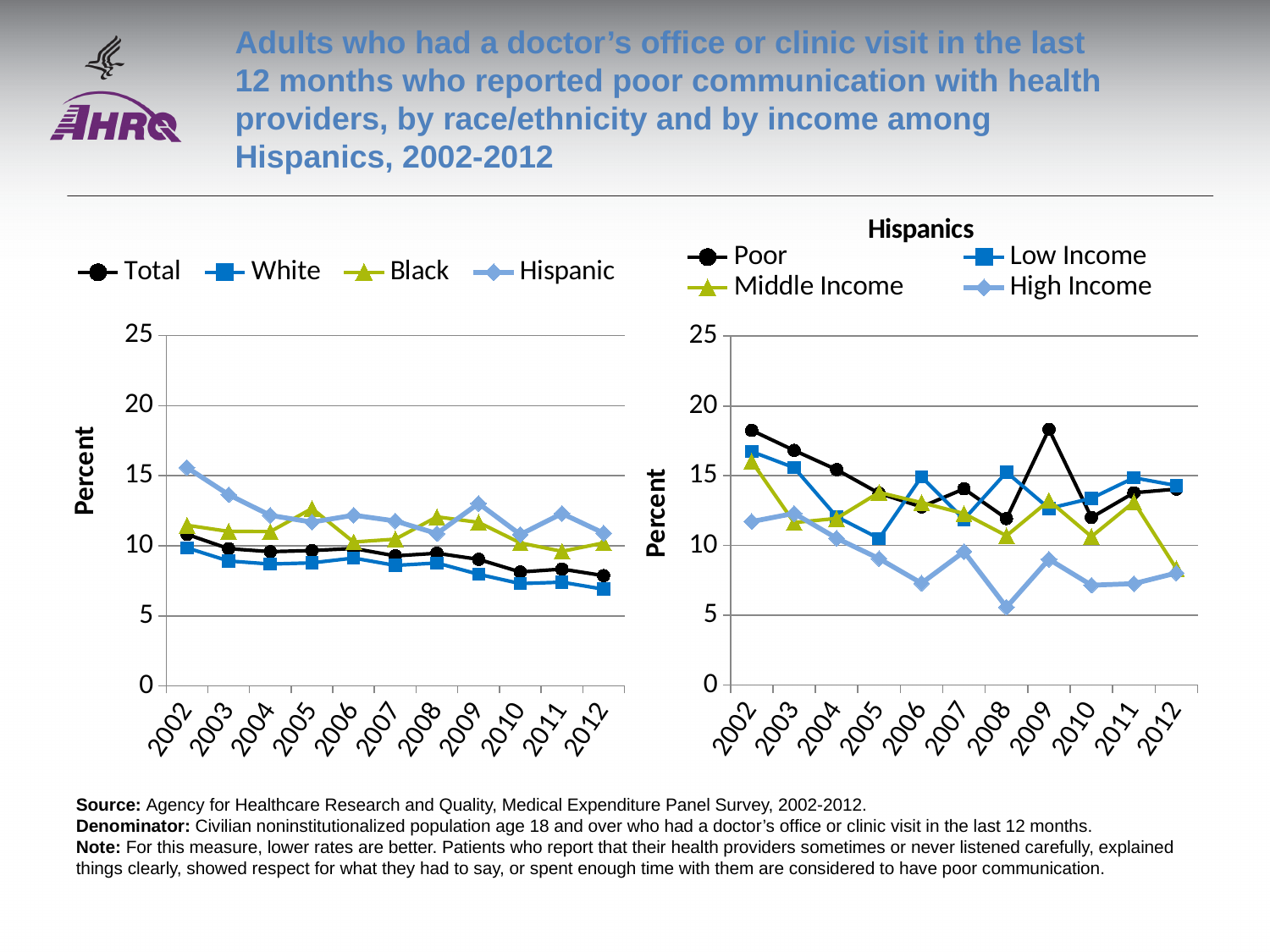
In the left chart, is the value for White in 2012 greater or less than 10? less What kind of chart is the left chart (by race/ethnicity)? line chart In the right chart titled 'Hispanics', which series has the highest value in 2009? Poor In the right chart titled 'Hispanics', which is larger in 2002, Poor or High Income? Poor What is the title shown above the right chart? Hispanics In the left chart, which series has the highest value in 2002? Hispanic How many years are shown on the x axis of the right chart titled 'Hispanics'? 11 In the right chart titled 'Hispanics', is the value for Poor in 2002 greater or less than 15? greater How many series does the legend of the left chart list? 4 In the right chart titled 'Hispanics', is the value for High Income in 2008 greater or less than 10? less In the left chart, does the Total series rise or fall from 2002 to 2012? fall In the left chart, which series has the lowest value in 2012? White